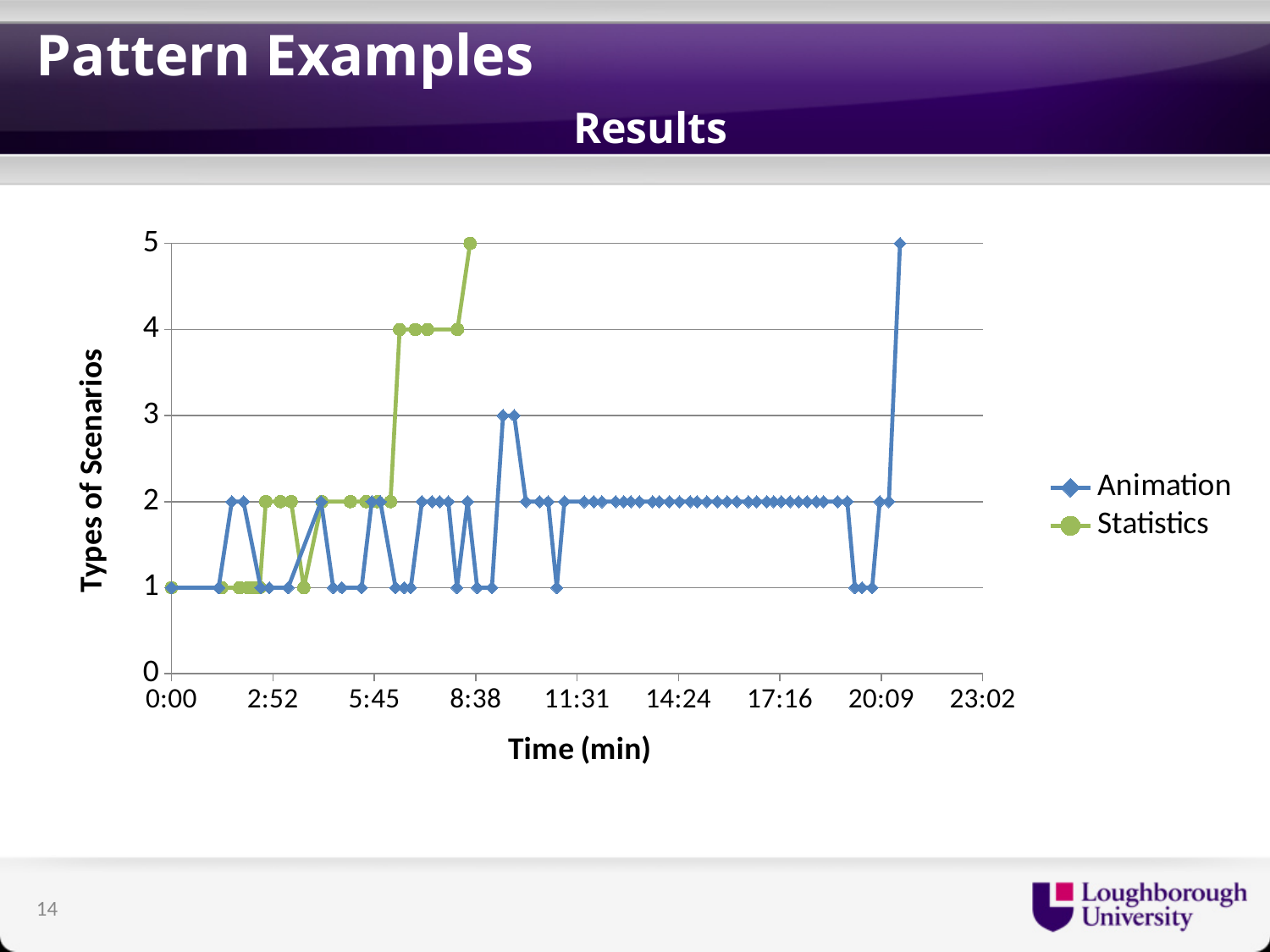
What is the value of the Animation series at 0:00? 1 What is the title of the x axis? Time (min) Is the value of the Animation series at 14:24 greater or less than 3? less Near 8:38, which series has the higher value, Animation or Statistics? Statistics Does the Statistics series overall rise or fall along the x axis? rise What kind of chart is shown on the slide? line chart How many series does the legend list? 2 What are the two series named in the legend? Animation and Statistics How many tick labels are shown on the x axis? 9 What is the highest value reached by the Statistics series? 5 What is the highest value reached by the Animation series? 5 What is the lowest value reached by the Animation series? 1